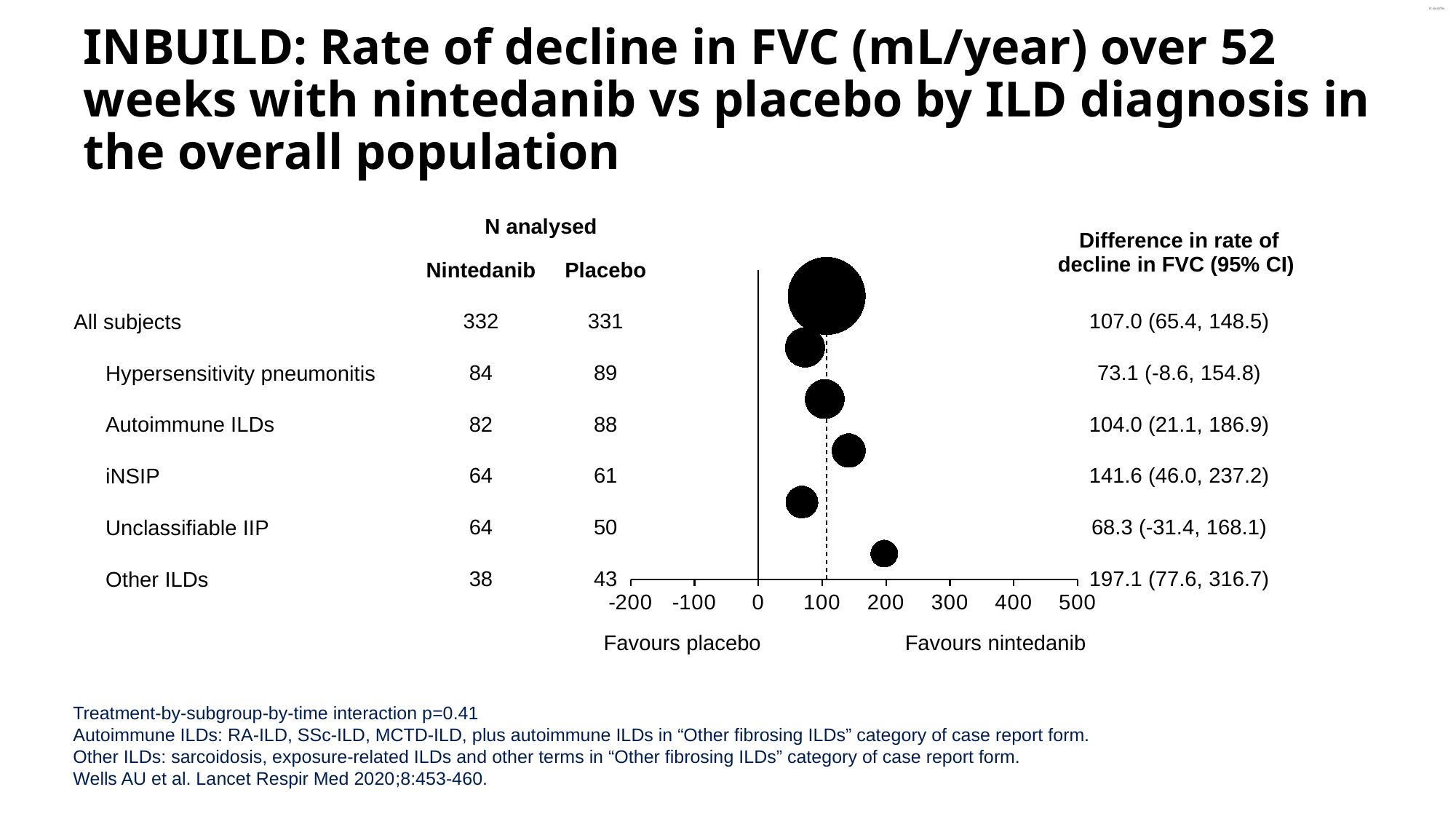
What does the right side of the x axis favour according to the label below the axis? Favours nintedanib What is the point estimate of the difference in rate of decline in FVC for iNSIP? 141.6 Which ILD diagnosis subgroup has the largest point estimate for the difference in rate of decline in FVC? Other ILDs What is the difference in rate of decline in FVC for All subjects? 107.0 (65.4, 148.5) Is the point estimate for Other ILDs greater or less than 100 on the x axis? greater How many patients were analysed in the nintedanib group for Hypersensitivity pneumonitis? 84 What is the 95% CI for the difference in rate of decline in FVC for Unclassifiable IIP? (-31.4, 168.1) What is the difference between the point estimates for Other ILDs and Hypersensitivity pneumonitis? 124.0 Which has a larger point estimate for the difference in rate of decline in FVC: Autoimmune ILDs or iNSIP? iNSIP How many patients were analysed in the placebo group for Other ILDs? 43 How many rows (subgroups including All subjects) are plotted in the chart? 6 Which ILD diagnosis subgroup has the smallest point estimate for the difference in rate of decline in FVC? Unclassifiable IIP